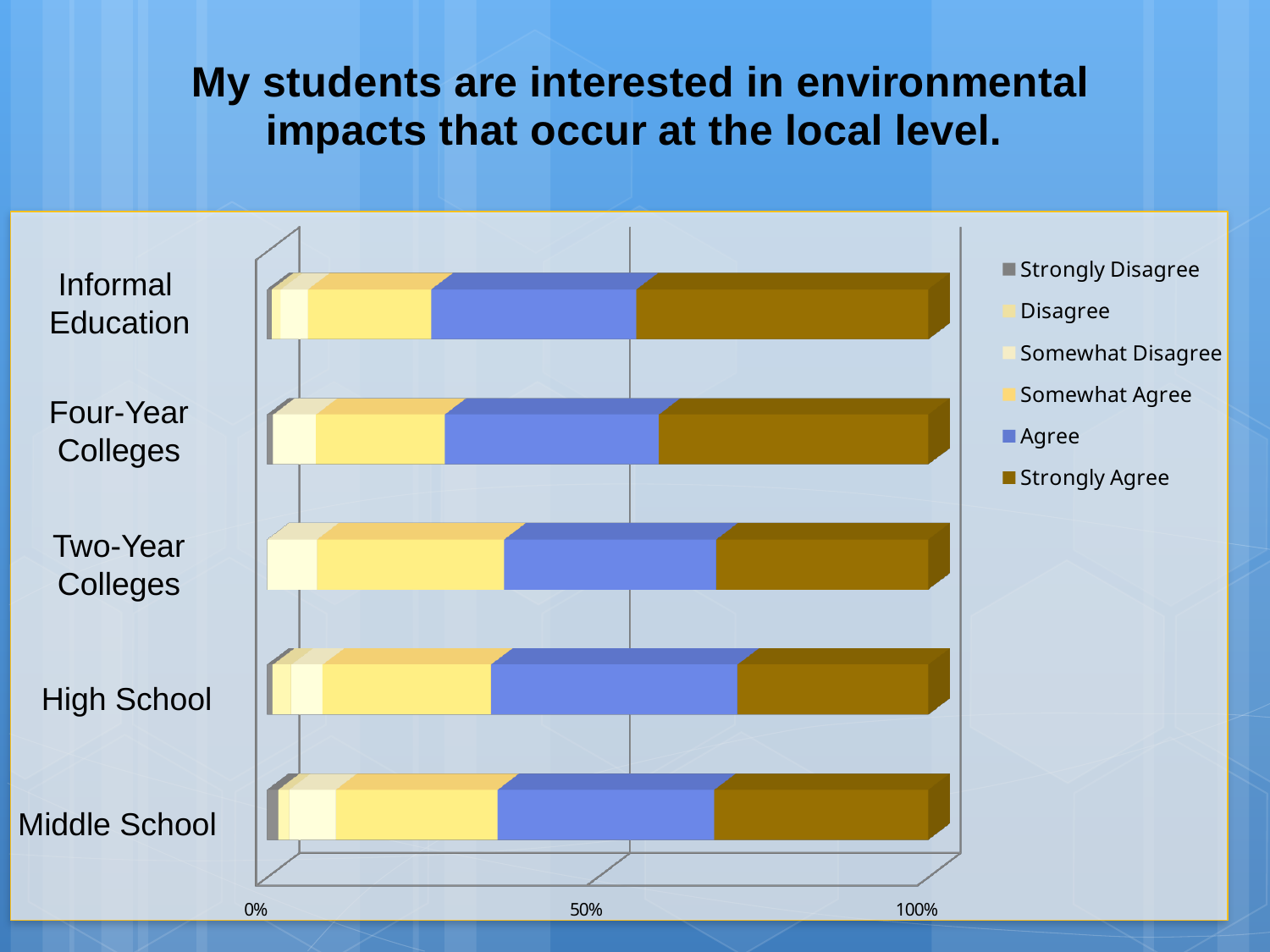
Which category is listed at the bottom of the chart? Middle School Is the combined share of Agree and Strongly Agree for Informal Education greater or less than 50%? greater How many series does the legend list? 6 Is the combined share of Agree and Strongly Agree for Two-Year Colleges greater or less than 50%? greater What is the title of the chart? My students are interested in environmental impacts that occur at the local level. Is the combined share of Somewhat Disagree and Somewhat Agree for Middle School greater or less than 50%? less Which legend entry is shown in brown? Strongly Agree Is the Strongly Agree segment larger for Informal Education or for Two-Year Colleges? Informal Education How many categories (education levels) are shown on the chart? 5 What kind of chart is shown on the slide? Stacked bar chart Which category has the largest Strongly Agree segment? Informal Education Is the Somewhat Agree segment larger for Two-Year Colleges or for Informal Education? Two-Year Colleges